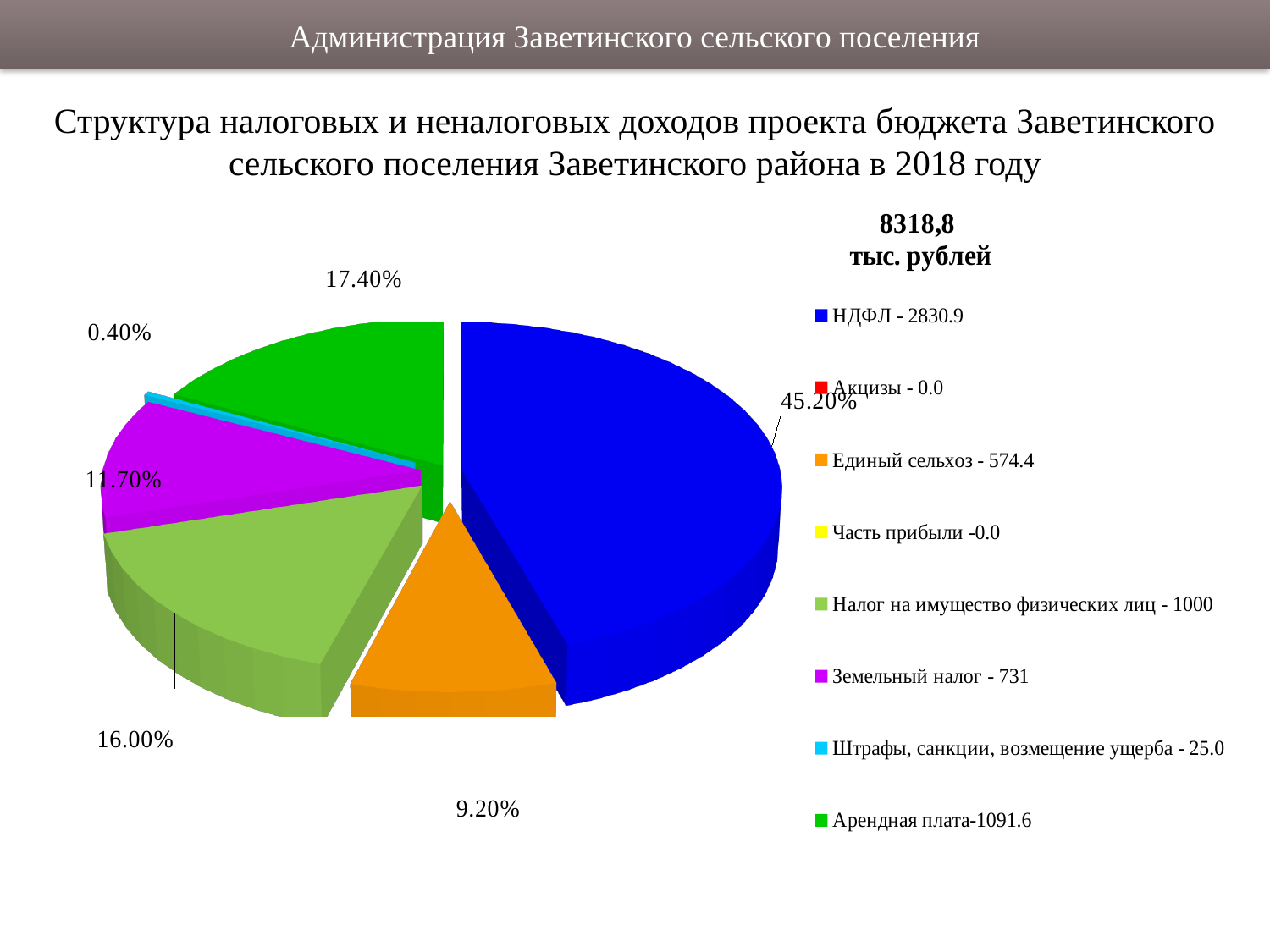
Which category has the largest slice of the pie? НДФЛ How many entries does the chart legend list? 8 What percentage share is shown for the НДФЛ slice? 45.20% What kind of chart is shown on the slide? pie chart What percentage share is shown for the Штрафы, санкции, возмещение ущерба slice? 0.40% Which slice is larger: Налог на имущество физических лиц or Земельный налог? Налог на имущество физических лиц What percentage share is shown for the Арендная плата slice? 17.40% What total amount is printed above the legend? 8318,8 тыс. рублей What percentage share is shown for the Земельный налог slice? 11.70% What is the difference in percentage points between the НДФЛ slice (45.20%) and the Арендная плата slice (17.40%)? 27.80% What value does the legend give for Единый сельхоз? 574.4 What value does the legend give for Налог на имущество физических лиц? 1000